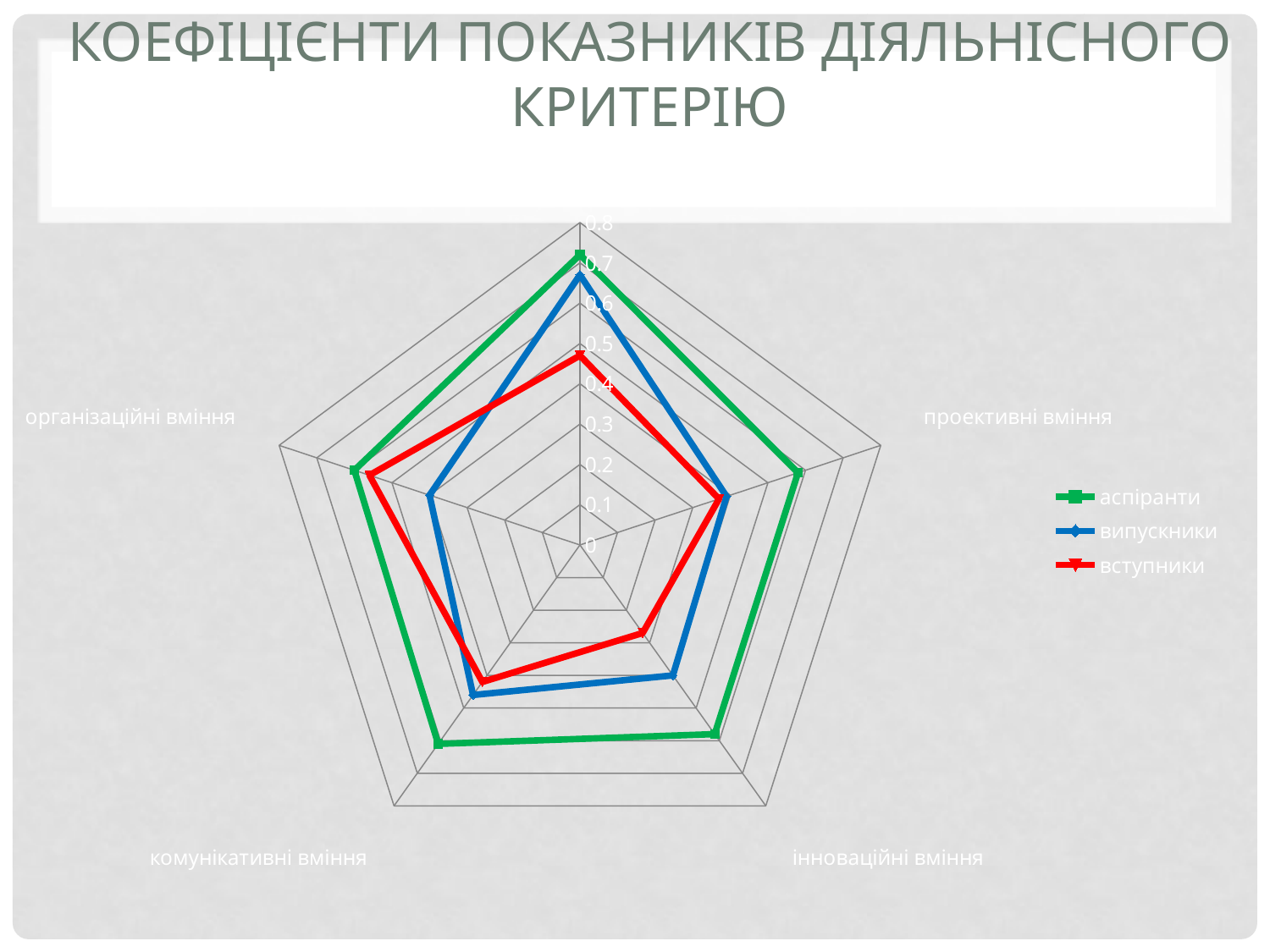
Which series has the larger value on інноваційні вміння, аспіранти or вступники? аспіранти Is the value for вступники on інноваційні вміння greater or less than 0.4? less Is the value for вступники on організаційні вміння greater or less than 0.5? greater What is the highest value shown on the radial axis scale? 0.8 What kind of chart is shown on the slide? radar chart Which series has the highest value on проективні вміння? аспіранти Which series is drawn in green? аспіранти How many axes (categories) does the radar chart have? 5 How many series does the legend list? 3 Which series has the larger value on організаційні вміння, випускники or вступники? вступники